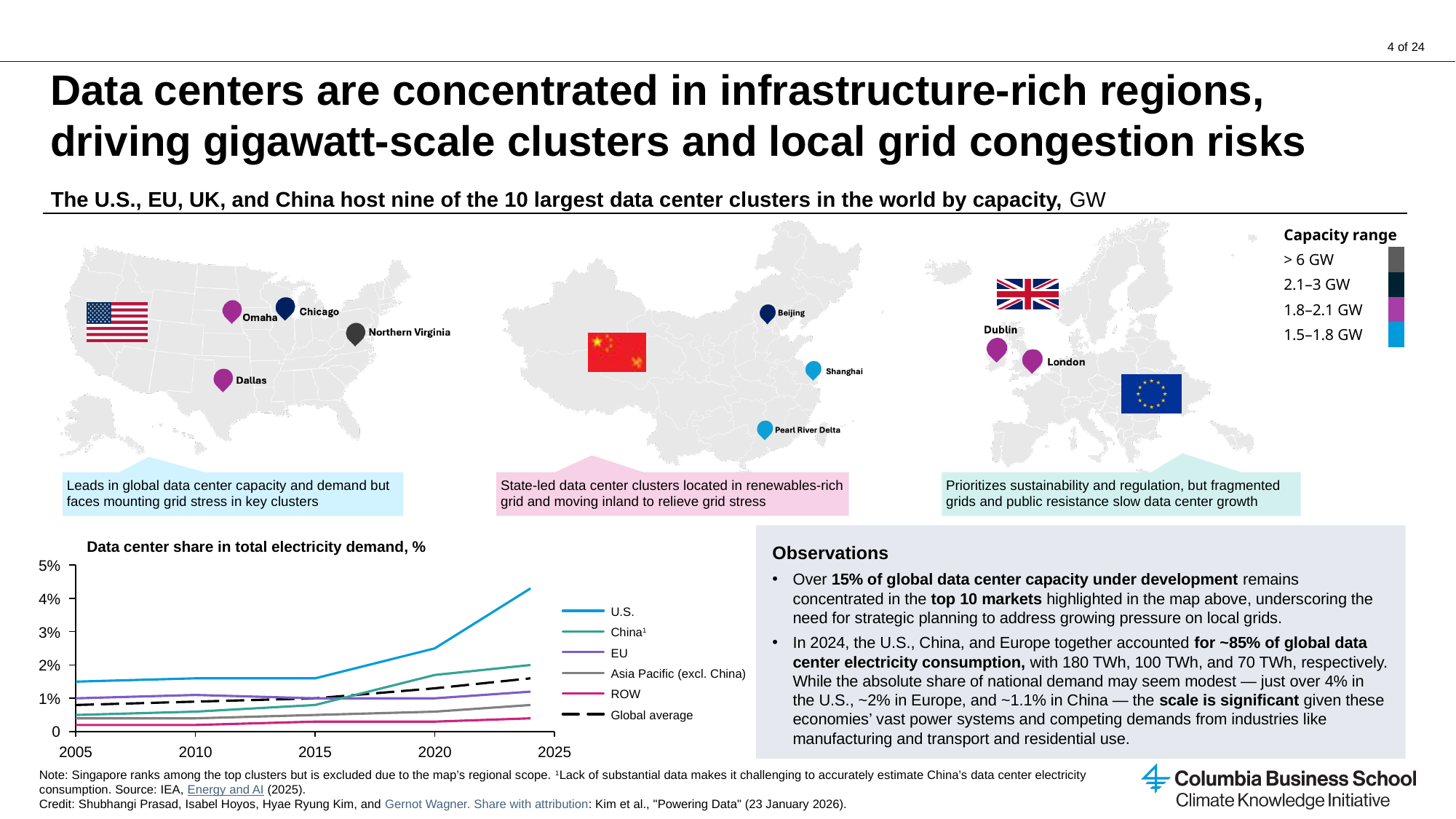
In the 'Data center share in total electricity demand, %' chart, which series has the lowest value across the whole period? ROW In the 'Data center share in total electricity demand, %' chart, is the final U.S. value greater or less than 4%? greater What kind of chart is 'Data center share in total electricity demand, %'? line chart In the 'Data center share in total electricity demand, %' chart, is the final Asia Pacific (excl. China) value greater or less than 1%? less How many year labels are shown on the x axis of the 'Data center share in total electricity demand, %' chart? 5 How many series does the legend of the 'Data center share in total electricity demand, %' chart list? 6 In the 'Data center share in total electricity demand, %' chart, which series has the highest value at the right end of the chart? U.S. In the 'Data center share in total electricity demand, %' chart, which series is drawn as a dashed line? Global average In the 'Data center share in total electricity demand, %' chart, is the final ROW value greater or less than 1%? less In the 'Data center share in total electricity demand, %' chart, does the U.S. line rise or fall between 2015 and the end of the series? rise In the 'Data center share in total electricity demand, %' chart, which is larger at the end of the series: U.S. or China? U.S. In the 'Data center share in total electricity demand, %' chart, which is larger at the end of the series: EU or ROW? EU